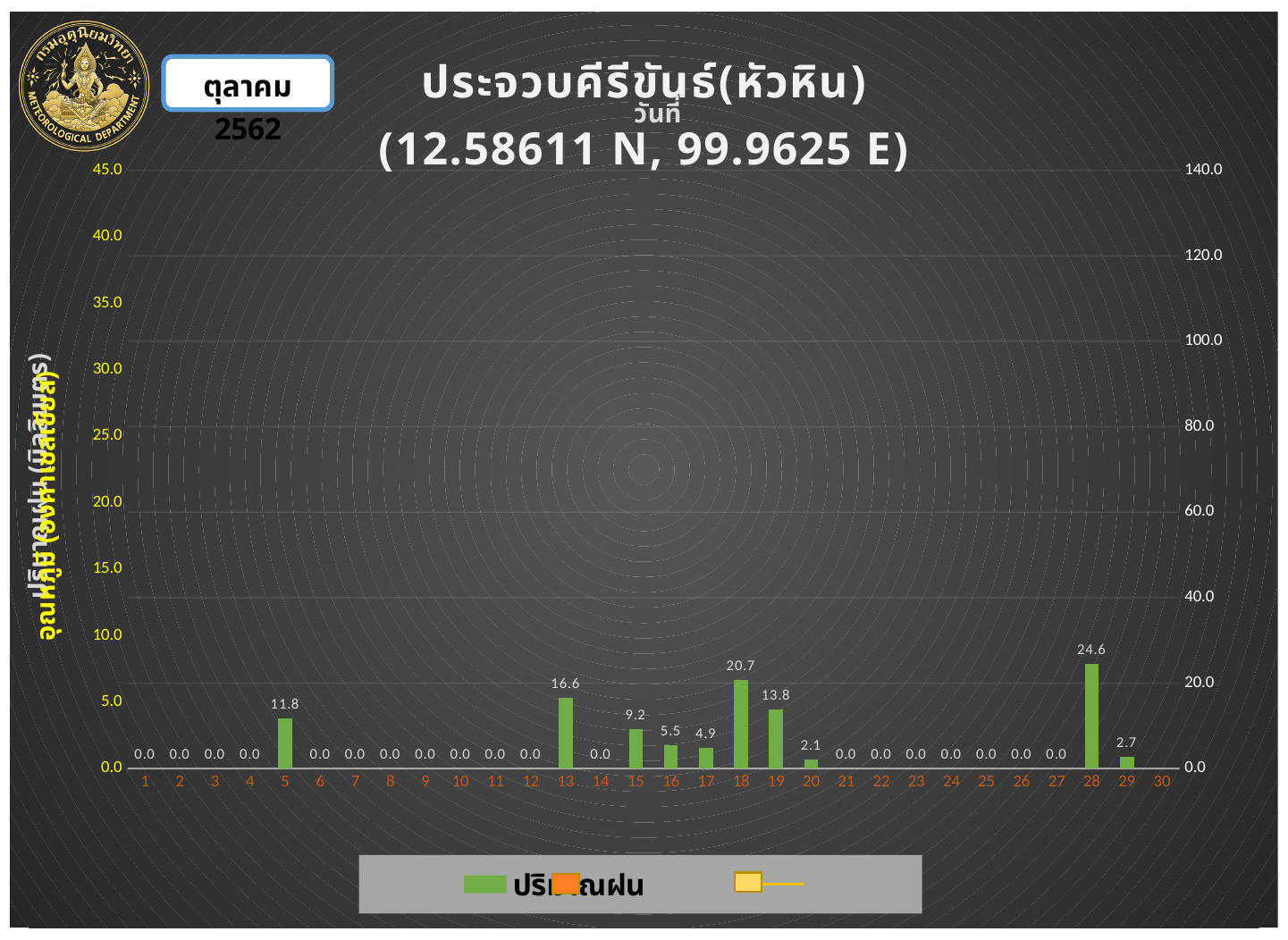
What is the value shown for day 13? 16.6 What is the value shown for day 18? 20.7 Which day has the highest value? 28 What is the difference between the values for day 28 and day 18? 3.9 What is the value shown for day 29? 2.7 What is the value shown for day 20? 2.1 How many days are shown on the x axis? 30 Which is larger, the value for day 15 or the value for day 16? day 15 What is the value shown for day 5? 11.8 What kind of chart is this? bar chart What is the value shown for day 28? 24.6 What is the difference between the values for day 13 and day 19? 2.8